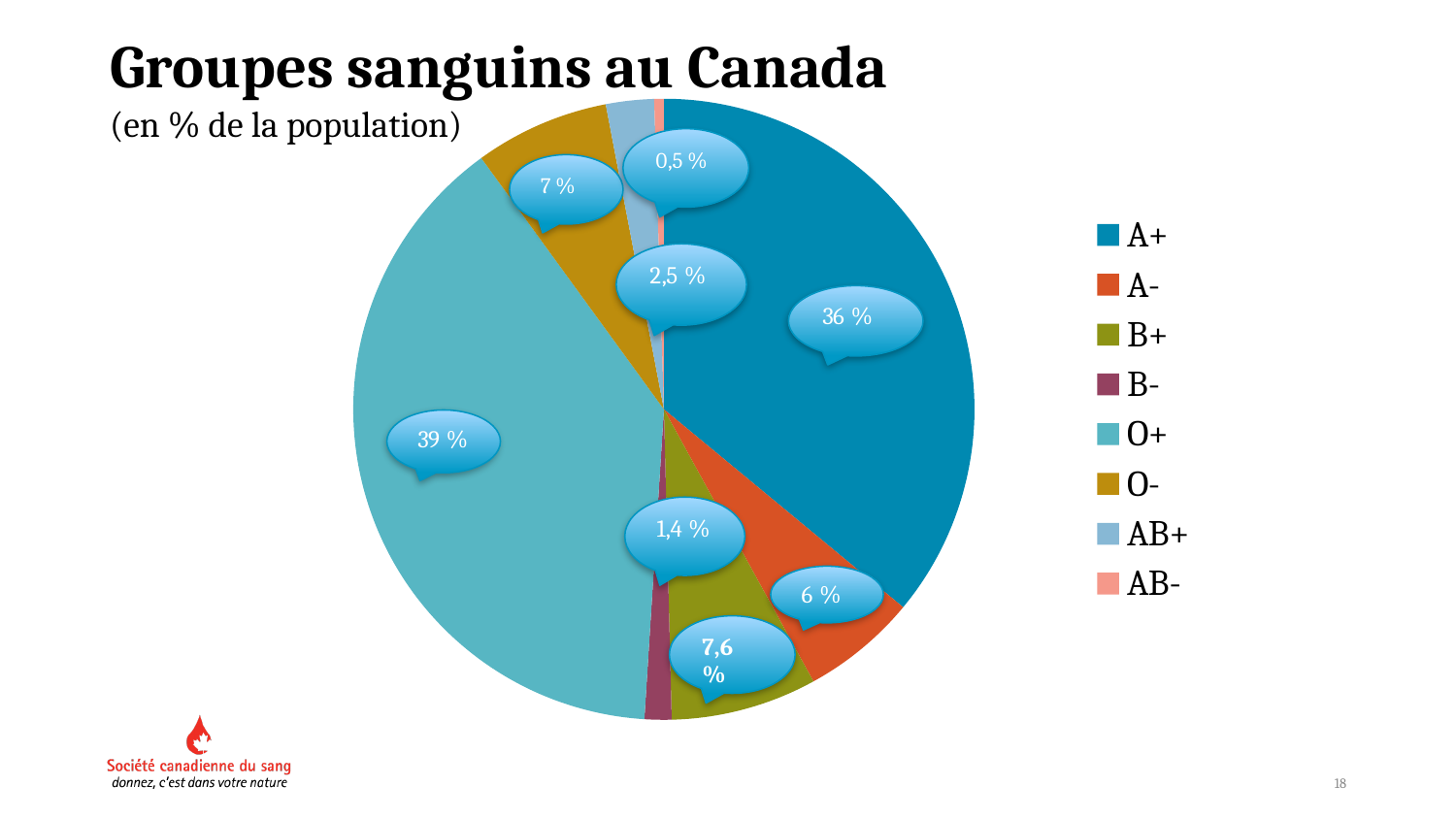
What percentage of the population has blood group B+? 7,6 % Which is larger, the share for A- or the share for O-? O- Which blood group has the smallest share of the population? AB- How many blood groups does the legend list? 8 Which blood group has the largest share of the population? O+ What percentage of the population has blood group AB-? 0,5 % By how many percentage points does the share for O+ exceed the share for A+? 3 What percentage of the population has blood group B-? 1,4 % What is the title of the chart? Groupes sanguins au Canada What kind of chart is shown on the slide? pie chart What percentage of the population has blood group A+? 36 % What percentage of the population has blood group O+? 39 %